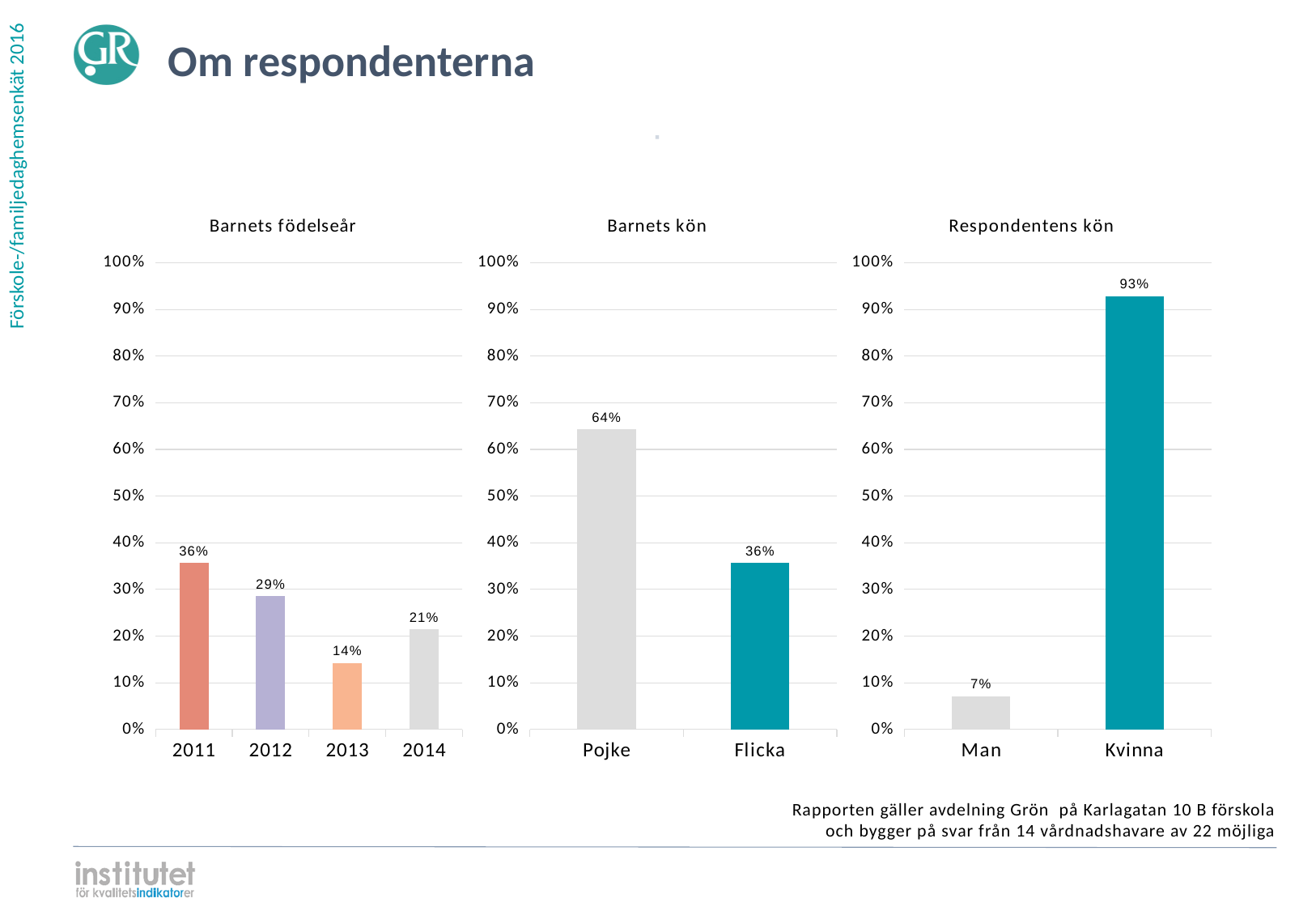
In the 'Barnets födelseår' chart, which birth year has the lowest value? 2013 In the 'Barnets födelseår' chart, do the values rise or fall from 2011 to 2013? fall In the 'Barnets födelseår' chart, what is the value for 2011? 36% In the 'Barnets kön' chart, what is the value for Pojke? 64% In the 'Barnets kön' chart, which is larger, Pojke or Flicka? Pojke In the 'Barnets kön' chart, what is the difference between Pojke and Flicka? 28% What kind of chart is the 'Barnets kön' chart? bar chart In the 'Respondentens kön' chart, what is the value for Kvinna? 93% In the 'Respondentens kön' chart, what is the value for Man? 7% In the 'Respondentens kön' chart, is the value for Kvinna greater or less than 90%? greater In the 'Barnets födelseår' chart, how many birth years are shown? 4 In the 'Barnets födelseår' chart, what is the difference between the values for 2012 and 2014? 8%